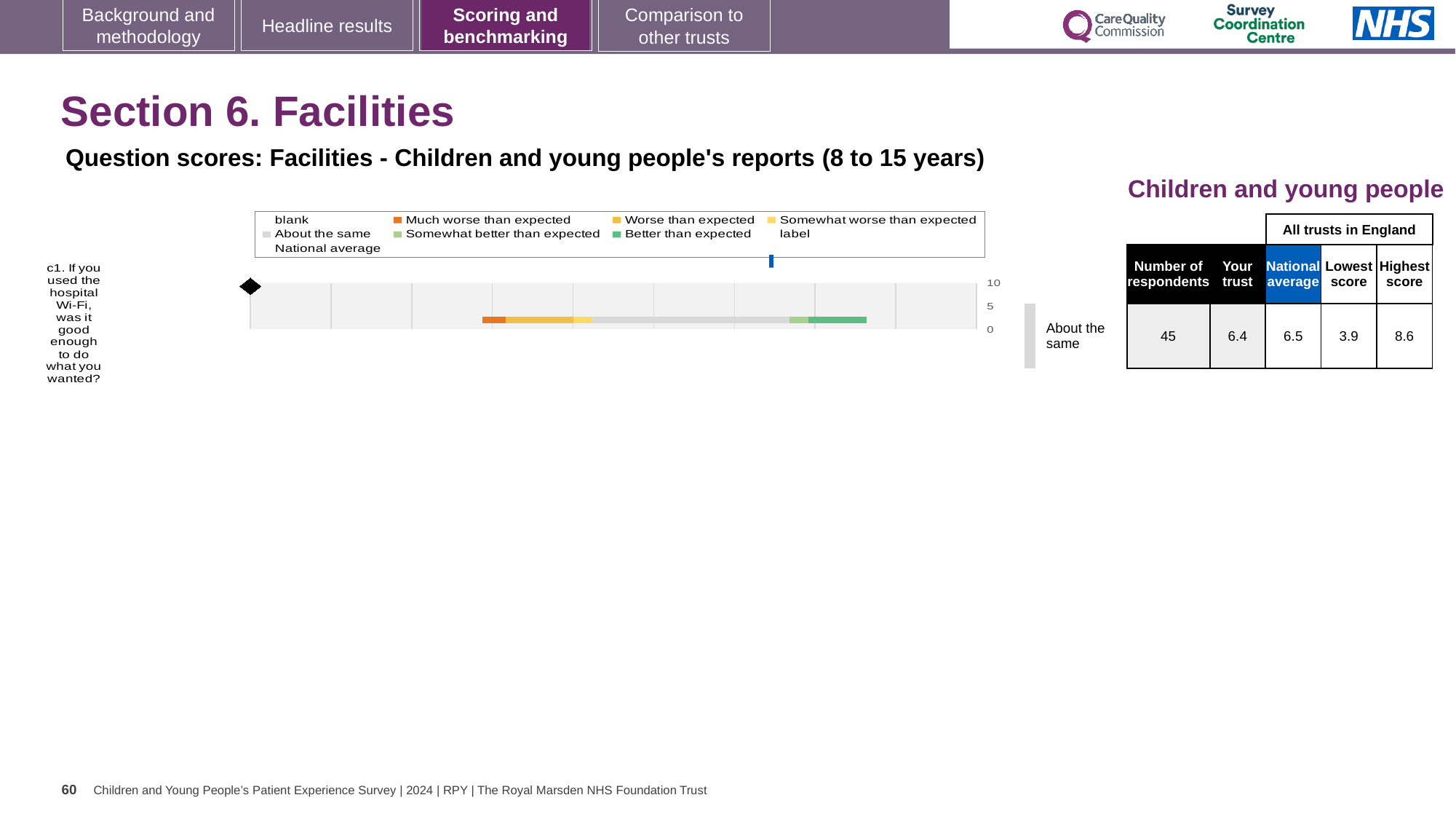
How many survey questions are plotted in the chart? 1 Which is larger for question c1: the 'Your trust' score or the national average? National average What kind of chart is shown on the slide? Bar chart According to the table, how many respondents answered question c1? 45 What is the difference between the highest score and the lowest score for question c1? 4.7 What benchmark category is question c1 assigned to? About the same According to the table, what is the 'Your trust' score for question c1 about hospital Wi-Fi? 6.4 According to the table, what is the national average score for question c1? 6.5 According to the table, what is the lowest score among all trusts in England for question c1? 3.9 According to the table, what is the highest score among all trusts in England for question c1? 8.6 Which colour in the legend represents 'Better than expected'? Green Which colour in the legend represents 'Much worse than expected'? Orange